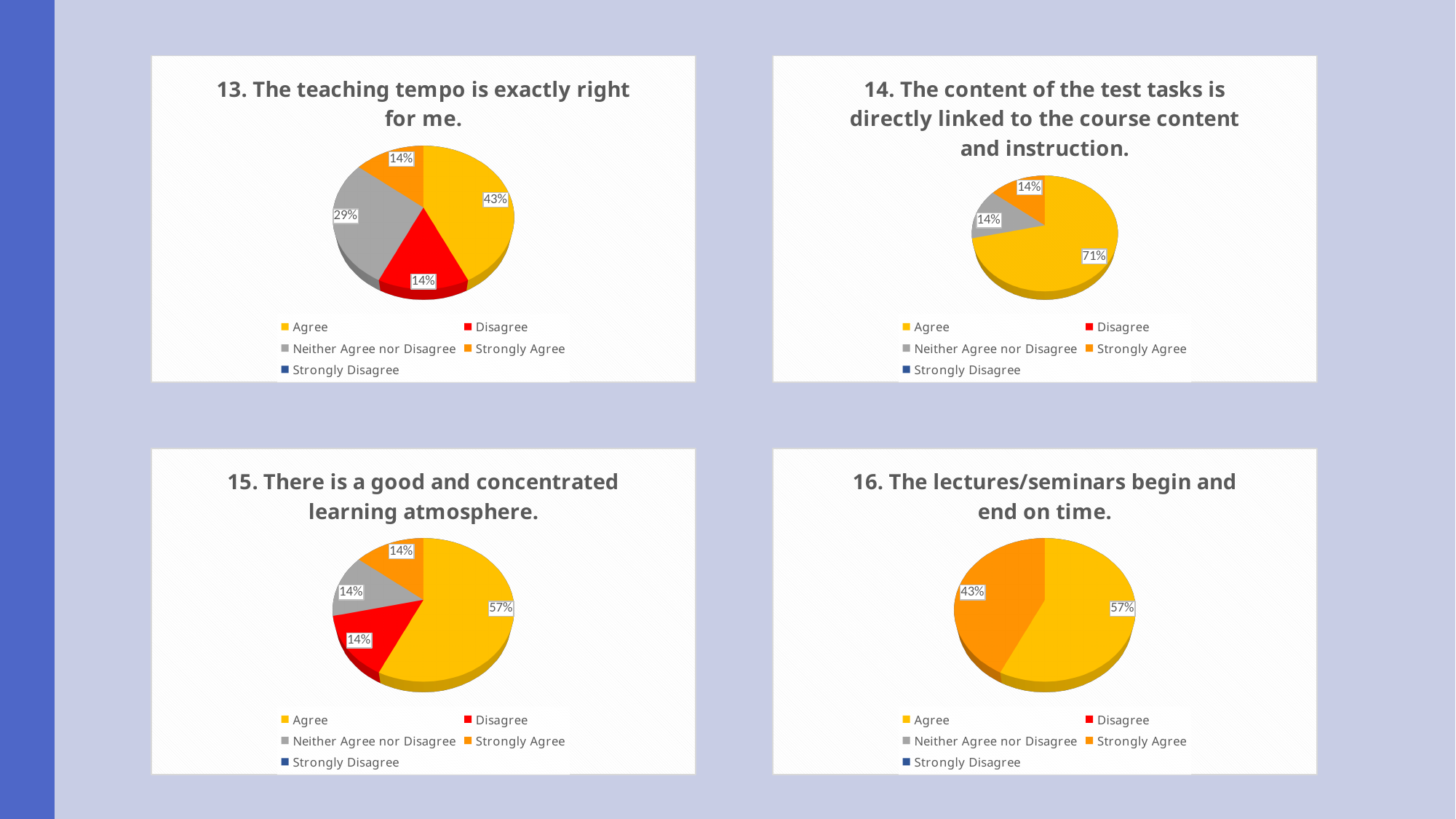
In the chart titled "15. There is a good and concentrated learning atmosphere.", what share of responses is Disagree? 14% In the chart titled "13. The teaching tempo is exactly right for me.", what share of responses is Neither Agree nor Disagree? 29% How many entries does the legend list in the chart titled "13. The teaching tempo is exactly right for me."? 5 In the chart titled "14. The content of the test tasks is directly linked to the course content and instruction.", what is the difference between the Agree share and the Strongly Agree share? 57% In the chart titled "13. The teaching tempo is exactly right for me.", what share of responses is Agree? 43% In the chart titled "16. The lectures/seminars begin and end on time.", what share of responses is Strongly Agree? 43% In the chart titled "14. The content of the test tasks is directly linked to the course content and instruction.", what share of responses is Agree? 71% What kind of chart is used for "14. The content of the test tasks is directly linked to the course content and instruction."? Pie chart In the chart titled "16. The lectures/seminars begin and end on time.", how many slices does the pie have? 2 In the chart titled "13. The teaching tempo is exactly right for me.", which response has the largest slice? Agree In the chart titled "16. The lectures/seminars begin and end on time.", which is larger, Agree or Strongly Agree? Agree In the chart titled "15. There is a good and concentrated learning atmosphere.", what share of responses is Agree? 57%